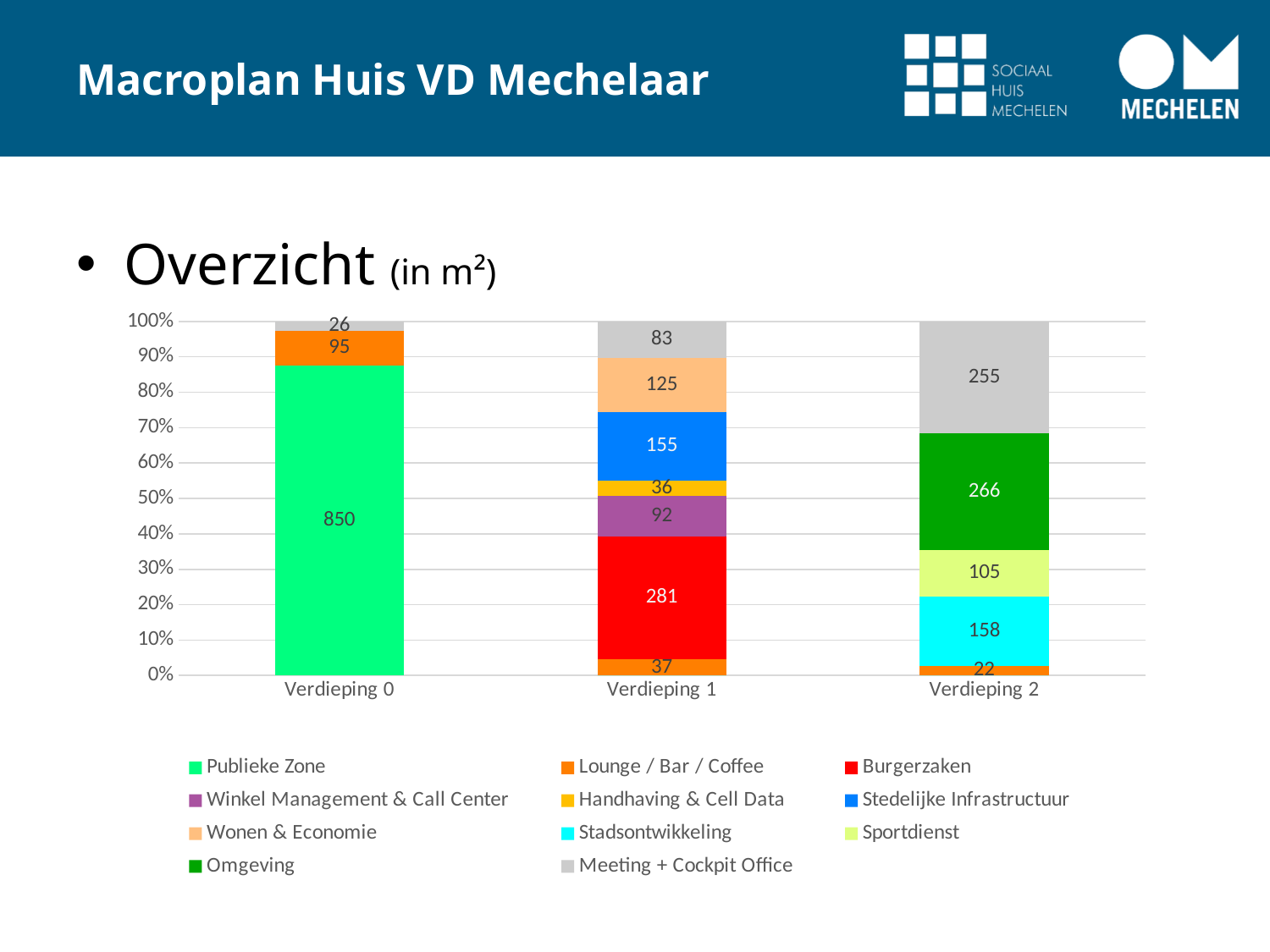
Which floor has the largest value for Meeting + Cockpit Office? Verdieping 2 How many floors (categories) are shown on the x axis? 3 Which is larger on Verdieping 1: Wonen & Economie or Winkel Management & Call Center? Wonen & Economie What is the difference between Omgeving and Stadsontwikkeling on Verdieping 2? 108 How many series does the legend list? 11 What is the value for Meeting + Cockpit Office on Verdieping 2? 255 What is the value for Burgerzaken on Verdieping 1? 281 What is the total of the values in the Verdieping 0 bar? 971 What kind of chart is shown on the slide? 100% stacked bar chart What is the value for Stedelijke Infrastructuur on Verdieping 1? 155 Which floor has the smallest value for Lounge / Bar / Coffee? Verdieping 2 What is the value for Publieke Zone on Verdieping 0? 850